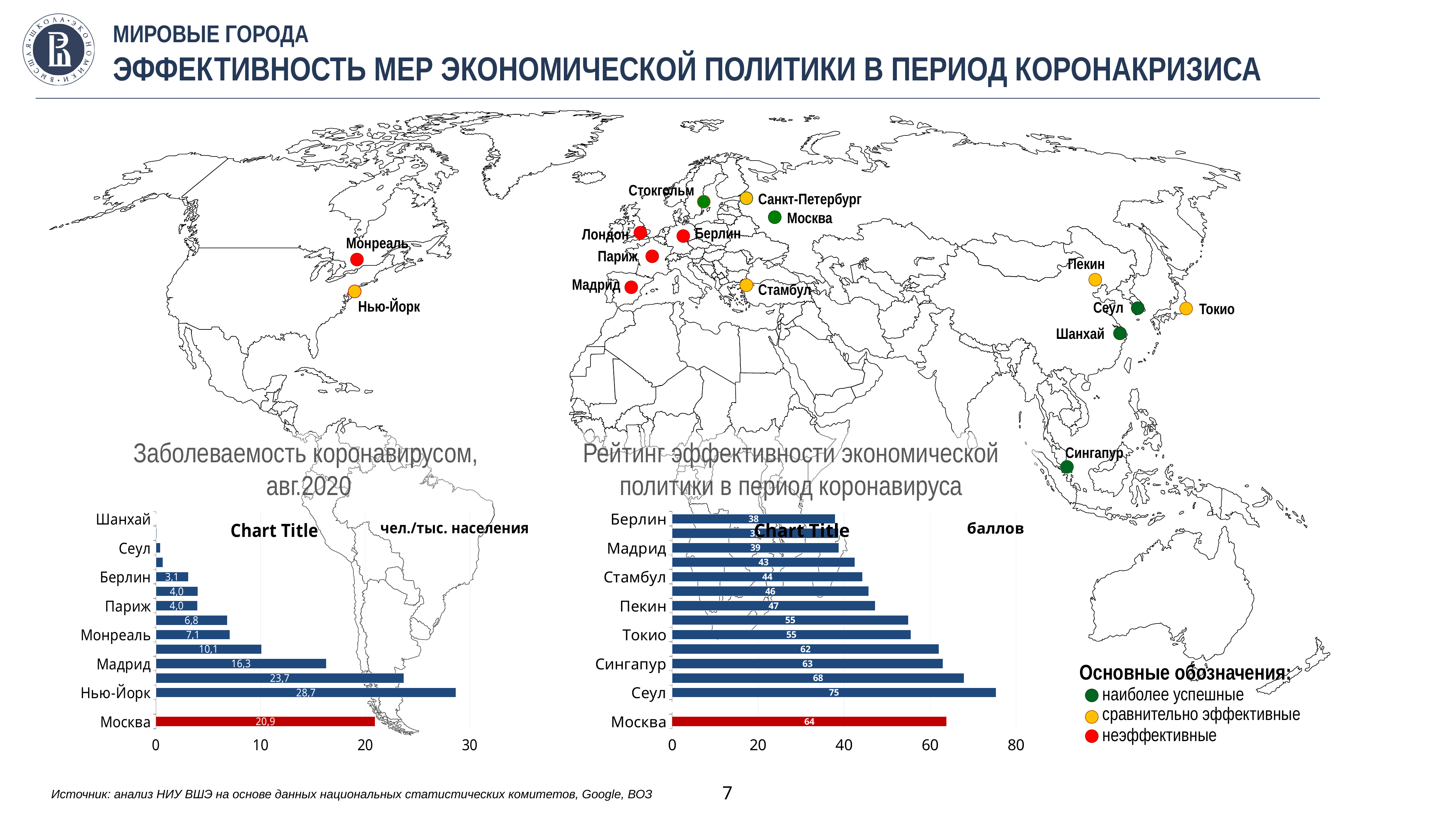
In the left chart (Заболеваемость коронавирусом, авг.2020), what is the difference between the values for Нью-Йорк and Москва? 7,8 In the right chart (Рейтинг эффективности экономической политики), is the value for Пекин greater or less than 40? greater In the left chart (Заболеваемость коронавирусом, авг.2020), which labelled city has the highest value? Нью-Йорк In the left chart (Заболеваемость коронавирусом, авг.2020), which is larger, the value for Мадрид or for Монреаль? Мадрид In the left chart (Заболеваемость коронавирусом, авг.2020), what is the value for Нью-Йорк? 28,7 What kind of chart is the right chart (Рейтинг эффективности экономической политики)? bar chart In the left chart (Заболеваемость коронавирусом, авг.2020), what is the value for Берлин? 3,1 In the right chart (Рейтинг эффективности экономической политики), what is the value for Москва? 64 In the left chart (Заболеваемость коронавирусом, авг.2020), what is the value for Москва? 20,9 In the right chart (Рейтинг эффективности экономической политики), what is the value for Сеул? 75 In the right chart (Рейтинг эффективности экономической политики), what is the difference between the values for Сеул and Москва? 11 In the right chart (Рейтинг эффективности экономической политики), which city has the highest value? Сеул